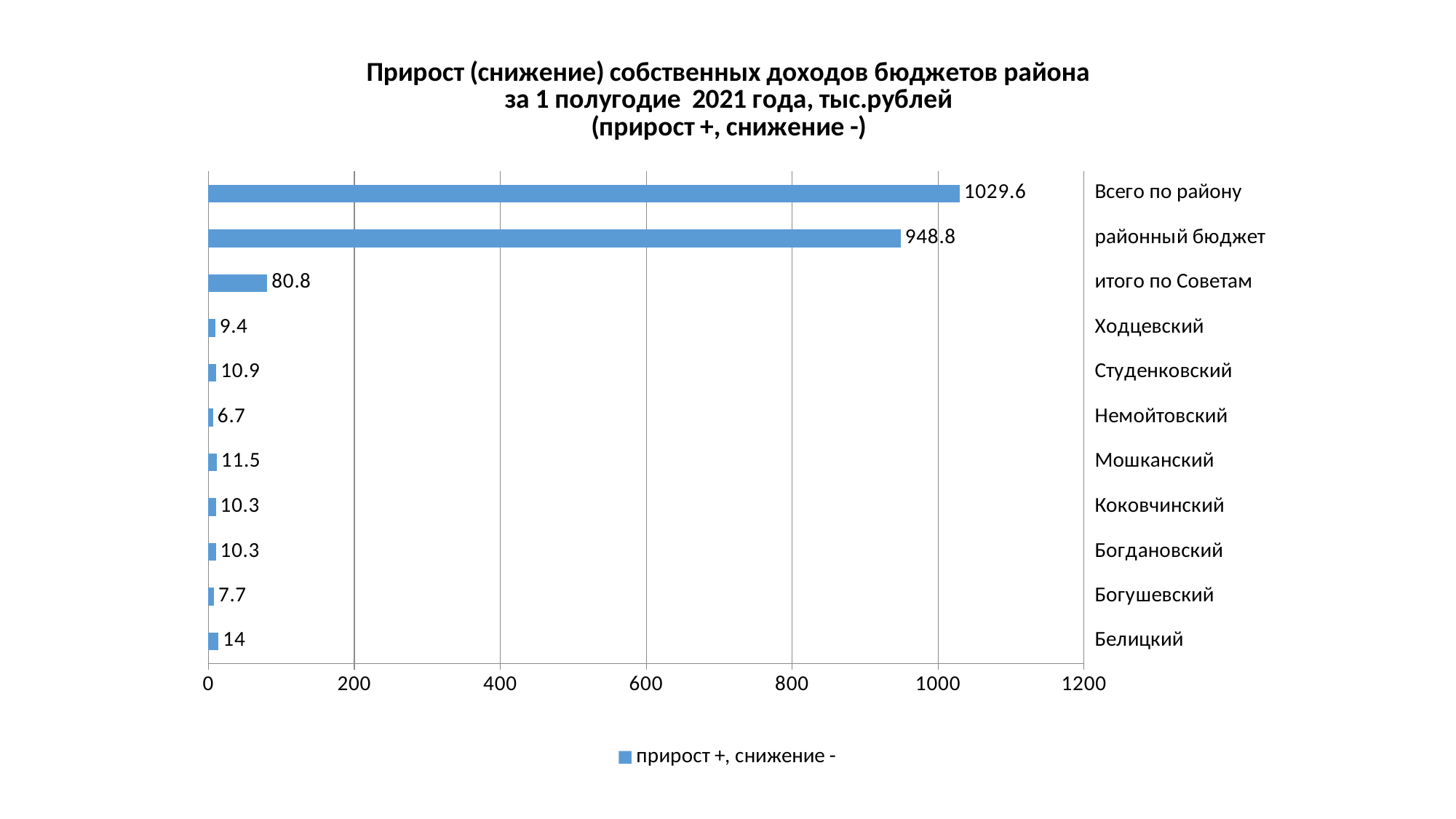
Which category has the highest value? Всего по району What is the value for итого по Советам? 80.8 What is the value for Всего по району? 1029.6 How many categories are shown in the chart? 11 Which is larger, the value for Студенковский or the value for Богушевский? Студенковский What is the value for Белицкий? 14 What kind of chart is shown on the slide? Bar chart What is the legend entry shown below the chart? прирост +, снижение - Which category has the lowest value? Немойтовский What is the value for Мошканский? 11.5 What is the difference between the values for Всего по району and районный бюджет? 80.8 What is the value for районный бюджет? 948.8